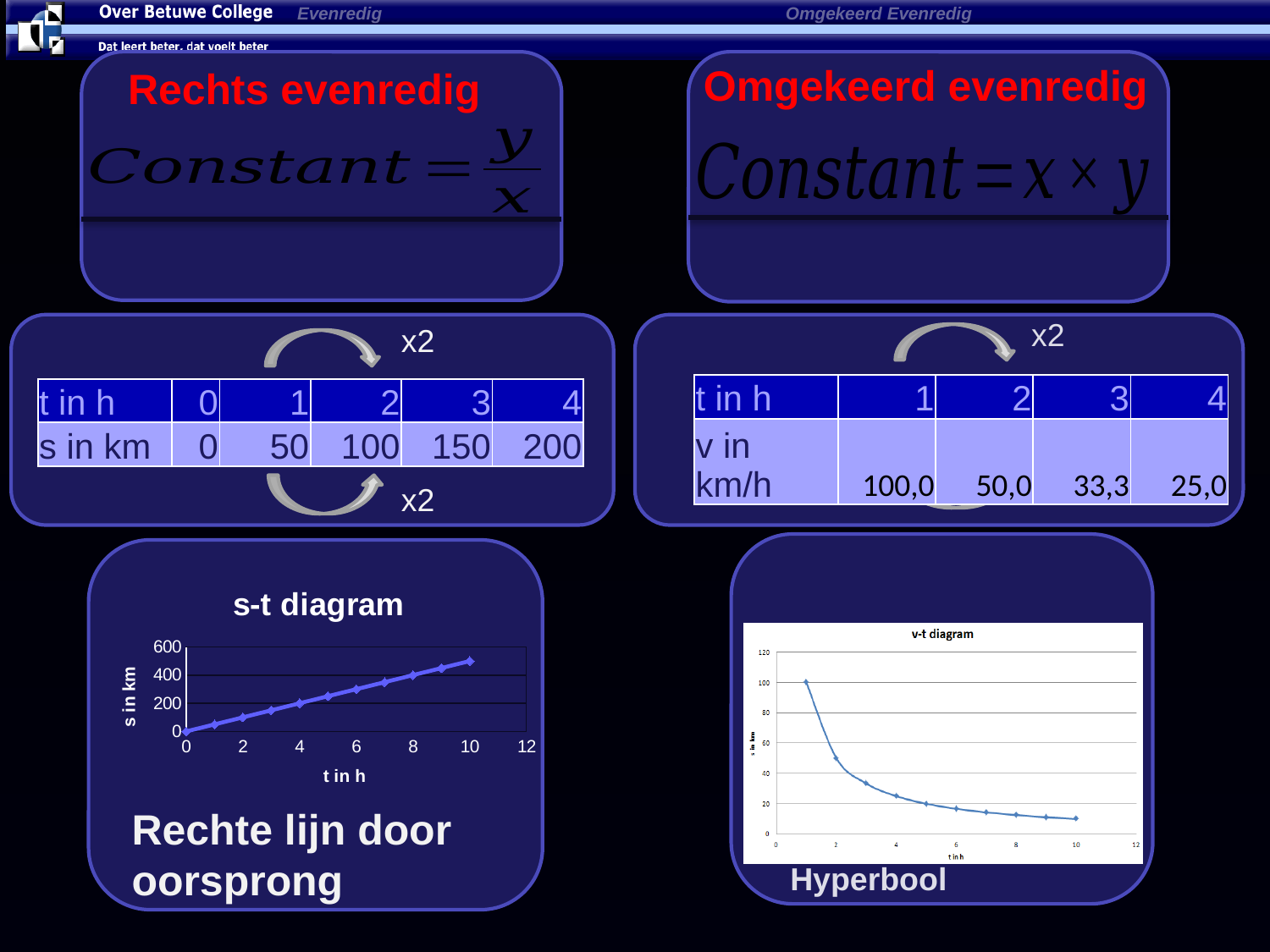
What kind of chart is the v-t diagram? line chart What kind of chart is the s-t diagram? line chart In the s-t diagram, is the value at t = 10 greater or less than 400? greater In the v-t diagram, at which value of t is the plotted value highest? 1 What is the label of the vertical axis of the s-t diagram? s in km In the v-t diagram, is the value at t = 10 greater or less than 20? less In the s-t diagram, at which value of t is the plotted value lowest? 0 In the s-t diagram, is the value at t = 2 greater or less than 200? less What is the title of the chart in the bottom-right panel? v-t diagram In the s-t diagram, do the values rise or fall as t increases? rise In the v-t diagram, do the values rise or fall as t increases? fall